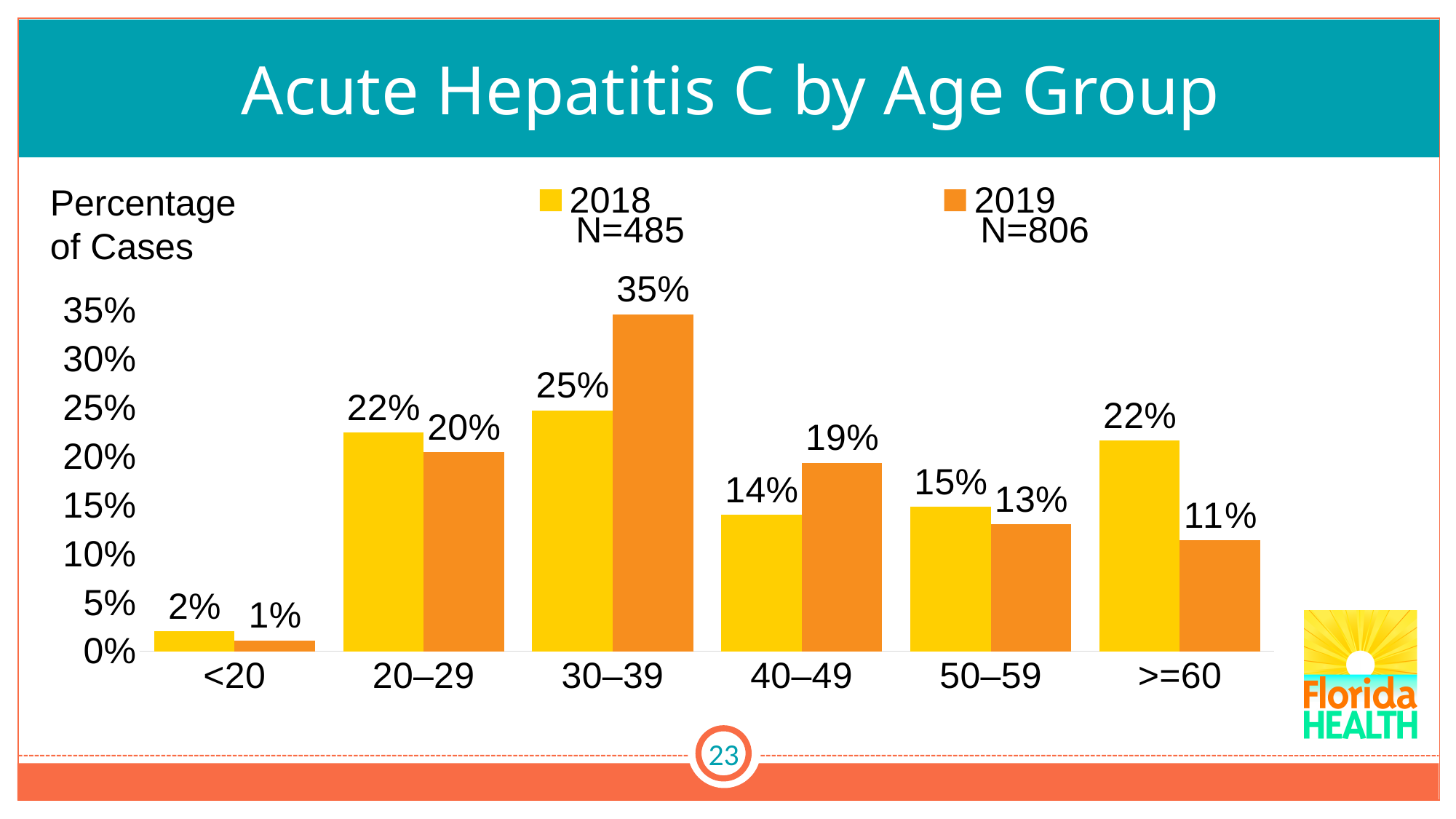
What kind of chart is shown on the slide? Bar chart Which year had a higher percentage of cases in the 40–49 age group, 2018 or 2019? 2019 Which age group had the lowest percentage of cases in 2019? <20 What percentage of cases were in the <20 age group in 2019? 1% What is the N value shown in the legend for 2019? N=806 What is the difference between the 2019 and 2018 percentages for the 30–39 age group? 10% What percentage of cases were in the 30–39 age group in 2019? 35% How many series does the legend list? 2 Which age group had the highest percentage of cases in 2018? 30–39 What percentage of cases were in the >=60 age group in 2018? 22% What is the difference between the 2018 and 2019 percentages for the >=60 age group? 11% How many age groups are shown on the x axis? 6